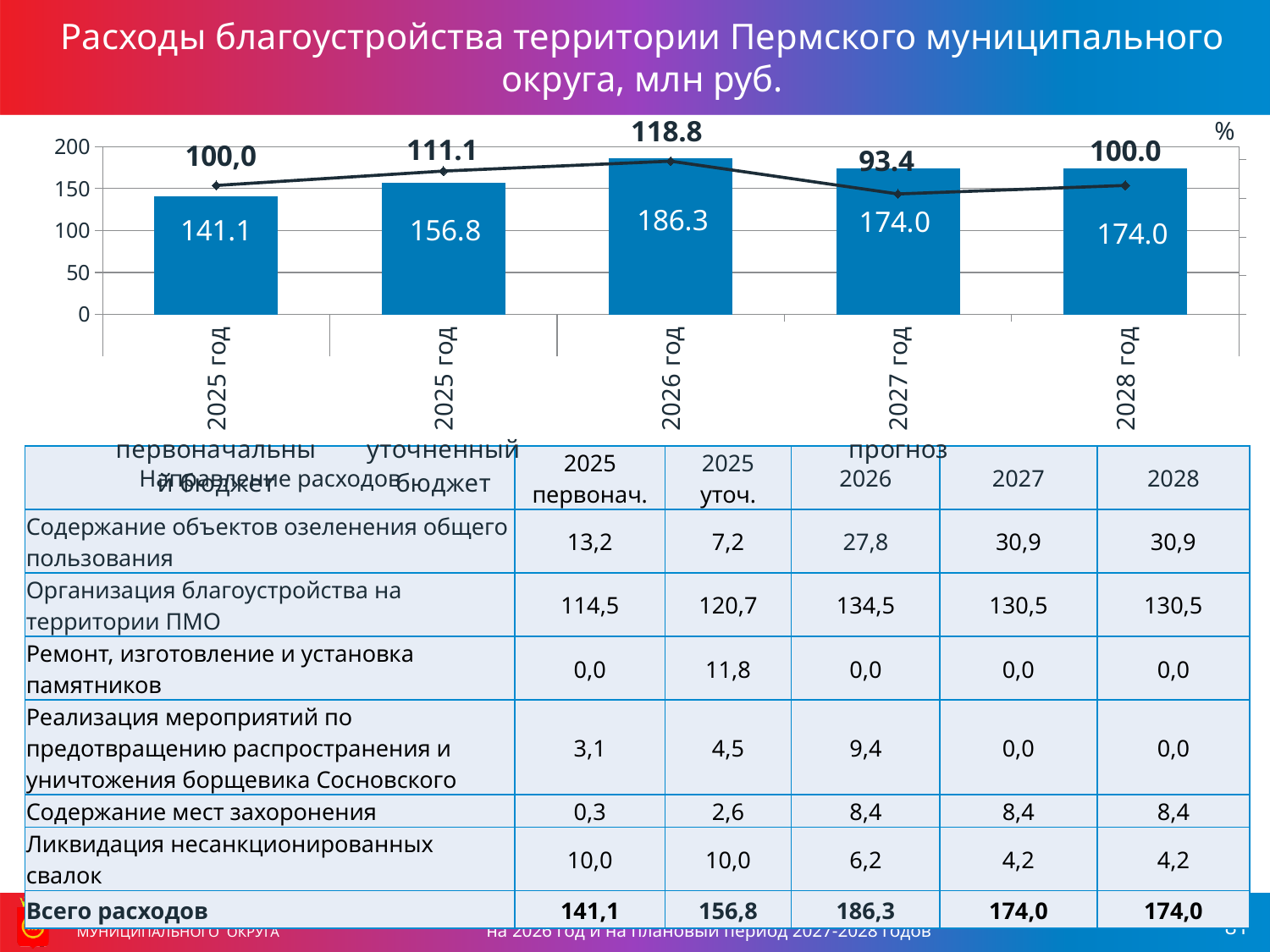
What is the value of the bar for 2025 год (уточненный бюджет)? 156.8 How many bars are shown in the chart? 5 What percentage value does the line show for 2027 год? 93.4 Which is larger: the bar for 2025 год (уточненный бюджет) or the bar for 2027 год? 2027 год Do the bar values rise or fall from 2025 год (первоначальный бюджет) to 2026 год? rise Is the bar for 2025 год (первоначальный бюджет) greater or less than 150? less What kind of chart is shown on the slide? bar chart with a line What is the difference between the bar for 2026 год and the bar for 2025 год (уточненный бюджет)? 29.5 What is the value of the bar for 2025 год (первоначальный бюджет)? 141.1 What is the value of the bar for 2026 год? 186.3 Which bar is the lowest? 2025 год (первоначальный бюджет) Which year has the highest bar? 2026 год